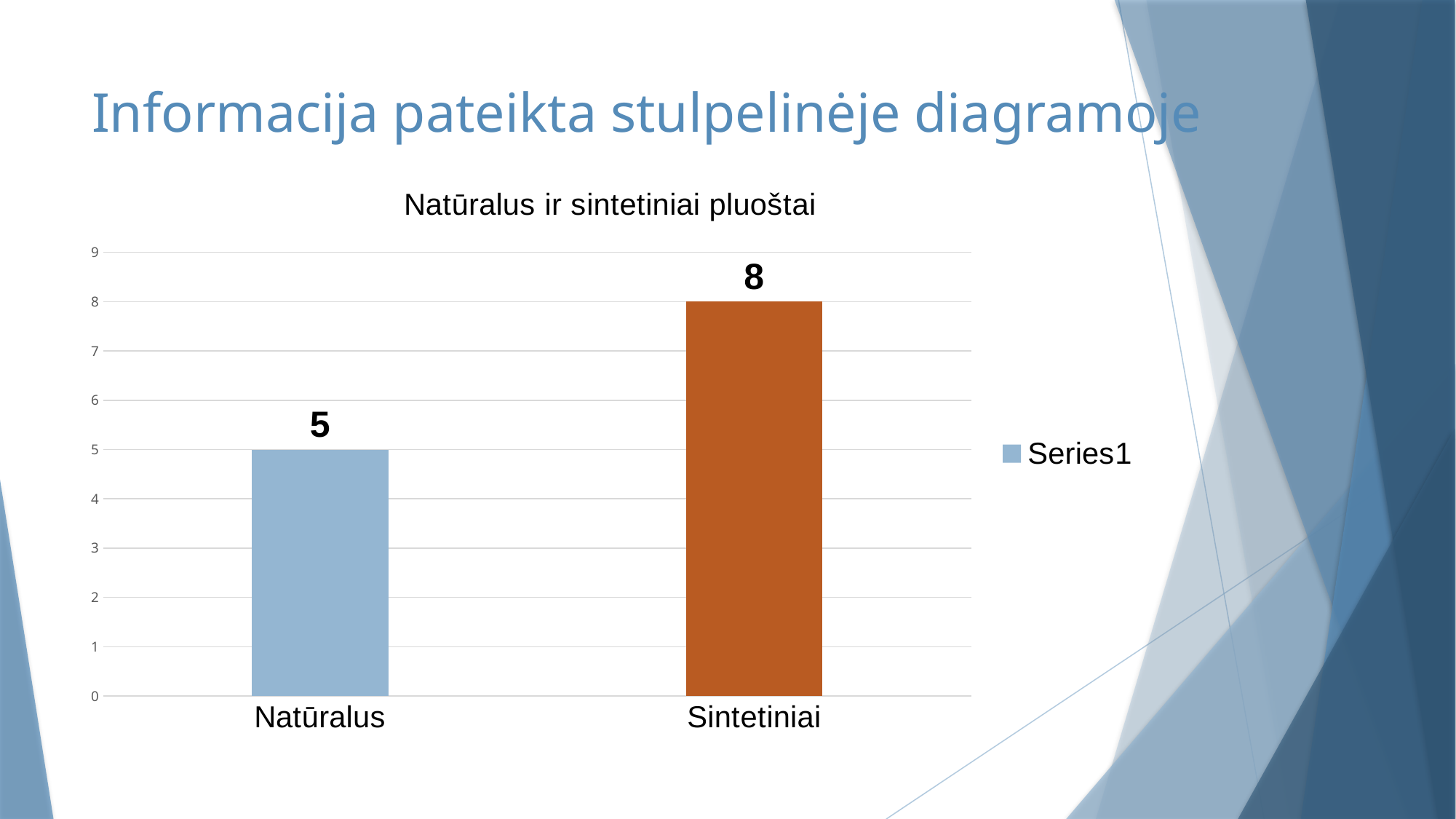
What is the title of the chart? Natūralus ir sintetiniai pluoštai What is the difference between the values for Sintetiniai and Natūralus? 3 Which is larger, the value for Natūralus or the value for Sintetiniai? Sintetiniai Is the value for Sintetiniai greater or less than 6? greater Which category has the highest value? Sintetiniai What is the value for Sintetiniai? 8 How many series does the legend list? 1 What is the value for Natūralus? 5 What kind of chart is shown on the slide? bar chart Is the value for Natūralus greater or less than 7? less Which category has the lowest value? Natūralus How many categories are shown on the x axis? 2